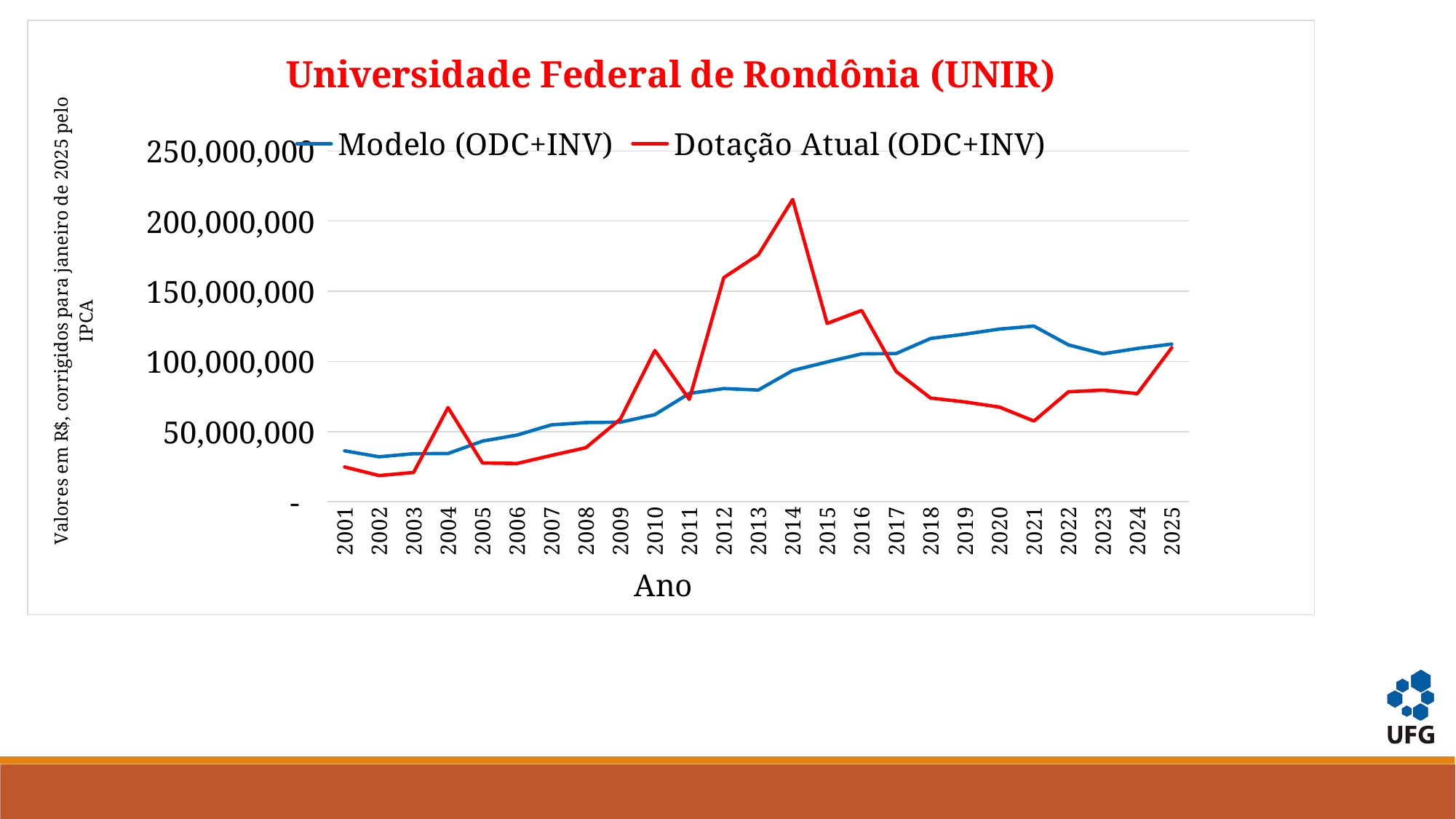
How many years are plotted along the x axis? 25 Is the value of Modelo (ODC+INV) in 2001 greater or less than 50,000,000? less How many series does the legend list? 2 What kind of chart is shown on the slide? line chart In 2013, which series has the larger value, Modelo (ODC+INV) or Dotação Atual (ODC+INV)? Dotação Atual (ODC+INV) In which year does the Dotação Atual (ODC+INV) series reach its highest value? 2014 What is the title of the chart? Universidade Federal de Rondônia (UNIR) In which year does the Dotação Atual (ODC+INV) series reach its lowest value? 2002 In 2020, which series has the larger value, Modelo (ODC+INV) or Dotação Atual (ODC+INV)? Modelo (ODC+INV) Is the value of Dotação Atual (ODC+INV) in 2014 greater or less than 200,000,000? greater Is the value of Dotação Atual (ODC+INV) in 2021 greater or less than 100,000,000? less In which year does the Modelo (ODC+INV) series reach its highest value? 2021